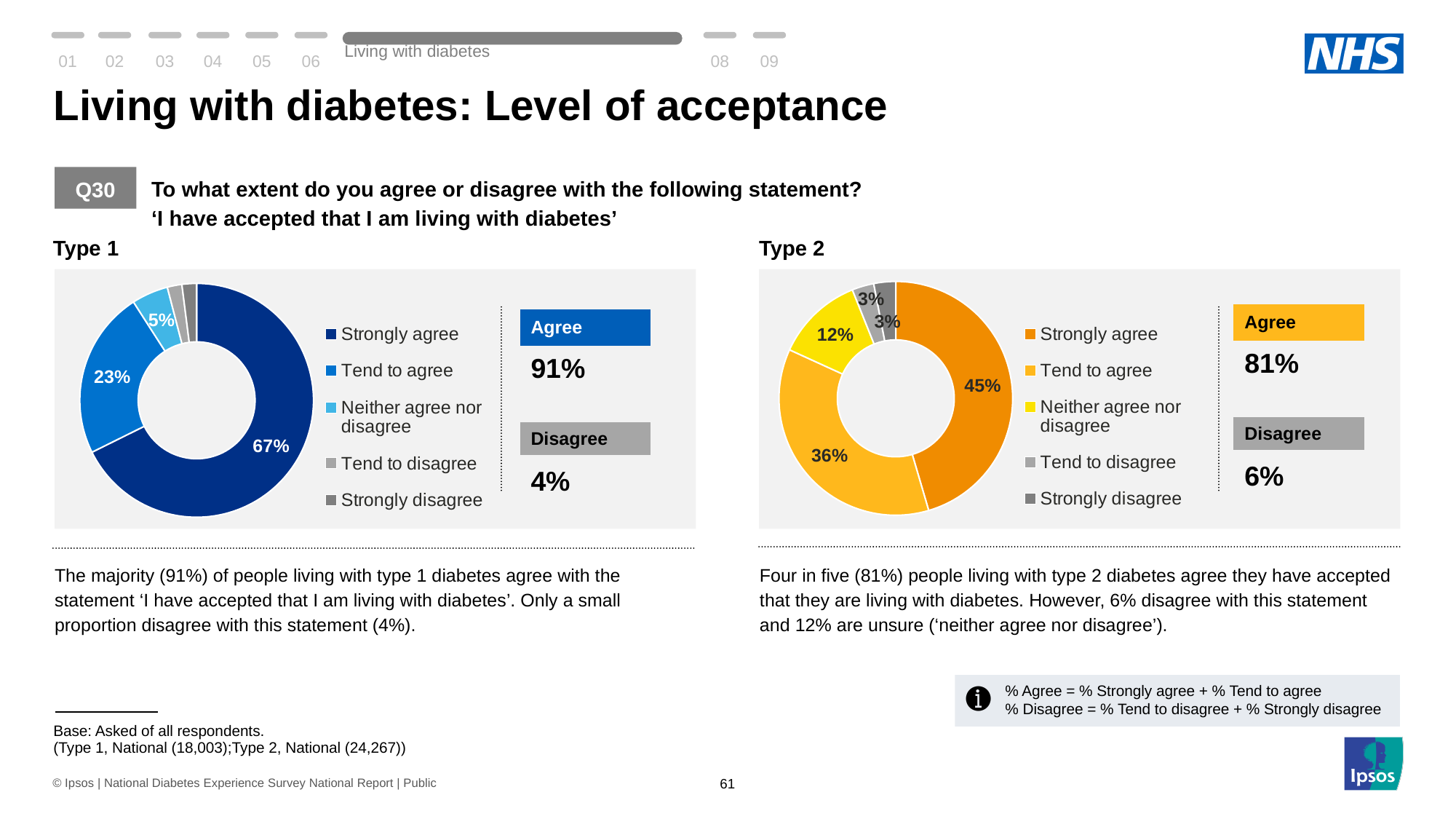
In the Type 2 chart, which response category has the largest share? Strongly agree What is the combined 'Disagree' percentage shown for the Type 1 chart? 4% In the Type 2 chart, what percentage of respondents said 'Neither agree nor disagree'? 12% In the Type 2 chart, what is the difference between the 'Strongly agree' and 'Tend to agree' shares? 9% In the Type 2 chart, what percentage of respondents said 'Tend to agree'? 36% In the Type 1 chart, what is the difference between the 'Strongly agree' and 'Tend to agree' shares? 44% Which chart shows a larger 'Strongly agree' share, Type 1 or Type 2? Type 1 What is the combined 'Agree' percentage shown for the Type 2 chart? 81% What type of chart is used to show the Type 2 results? Donut (pie) chart In the Type 1 chart, what percentage of respondents said 'Tend to agree'? 23% How many response categories does the legend of the Type 1 chart list? 5 In the Type 1 chart, what percentage of respondents said 'Strongly agree'? 67%